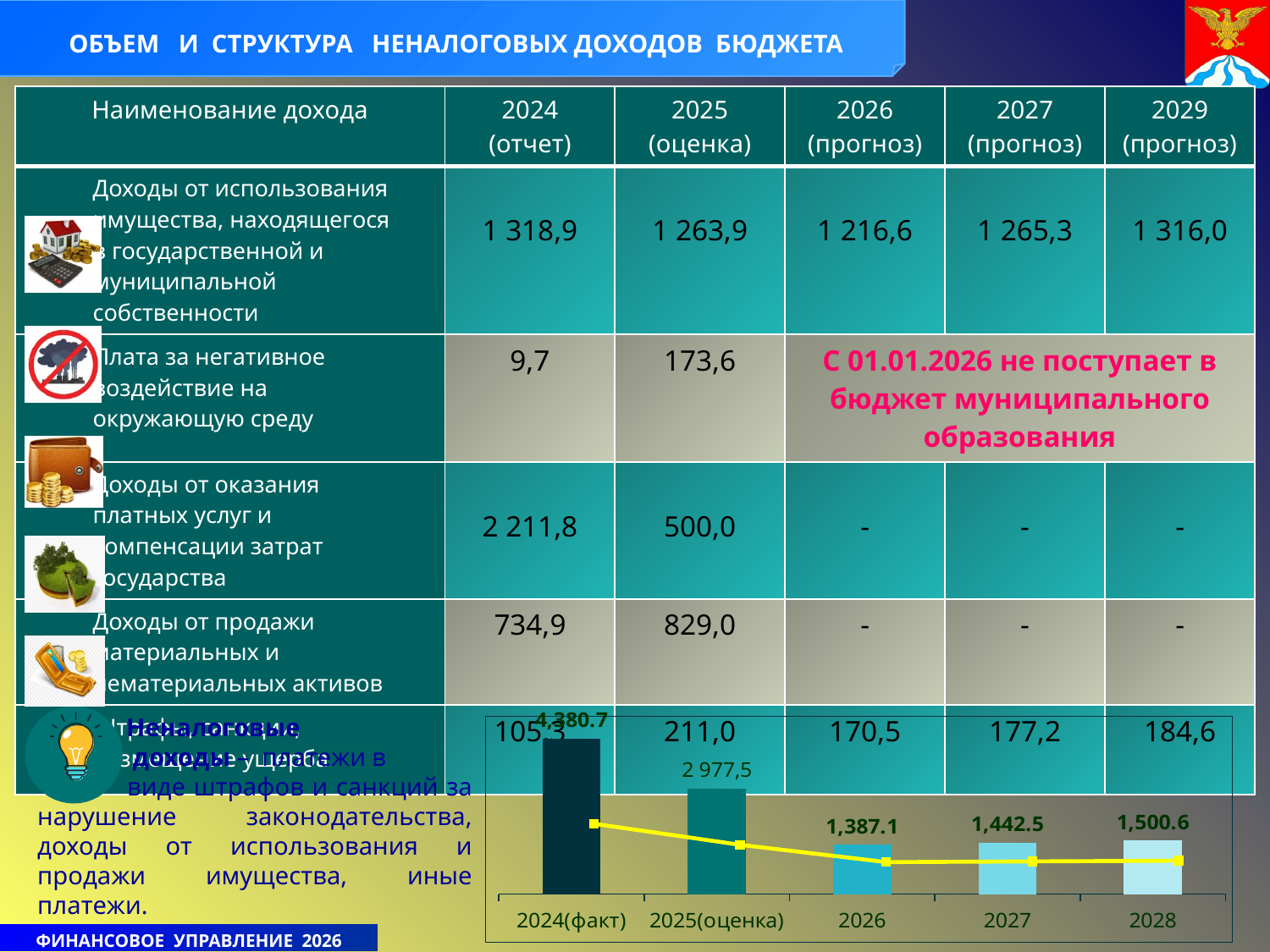
How many categories are shown on the x axis of the chart at the bottom of the slide? 5 In the chart at the bottom of the slide, what is the value labelled on the bar for 2025(оценка)? 2 977,5 In the chart at the bottom of the slide, do the bar values rise or fall from 2026 to 2028? rise In the chart at the bottom of the slide, what is the value labelled on the bar for 2026? 1,387.1 In the chart at the bottom of the slide, which category has the lowest bar? 2026 In the chart at the bottom of the slide, by how much does the bar value for 2028 exceed the bar value for 2027? 58.1 In the chart at the bottom of the slide, which bar is taller: 2025(оценка) or 2026? 2025(оценка) In the chart at the bottom of the slide, what is the value labelled on the bar for 2028? 1,500.6 In the chart at the bottom of the slide, what is the difference between the bar values for 2027 and 2026? 55.4 In the chart at the bottom of the slide, which category has the tallest bar? 2024(факт) In the chart at the bottom of the slide, what is the value labelled on the bar for 2027? 1,442.5 What kind of chart is shown at the bottom of the slide? bar chart